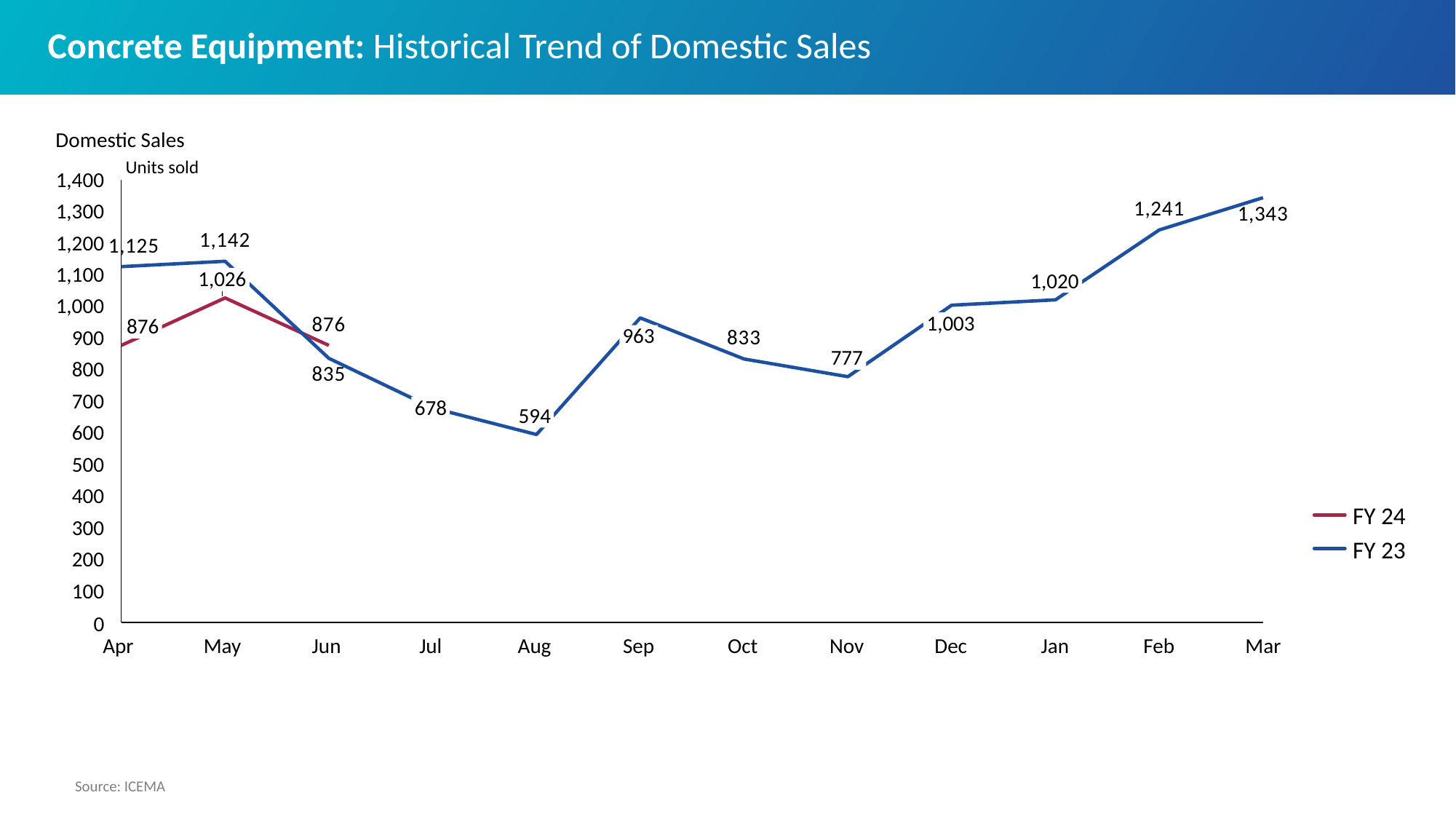
What is the label on the vertical axis? Units sold What is the FY 23 value for Aug? 594 Which is larger in Jun, the FY 24 value or the FY 23 value? FY 24 What is the FY 24 value for May? 1,026 Which month has the lowest FY 23 value? Aug Which month has the highest FY 23 value? Mar How many series does the legend list? 2 Does the FY 23 line rise or fall from Nov to Mar? Rise What type of chart is shown on the slide? Line chart How many months are shown on the x axis? 12 What is the difference between the FY 23 and FY 24 values for Apr? 249 What is the FY 23 value for Feb? 1,241